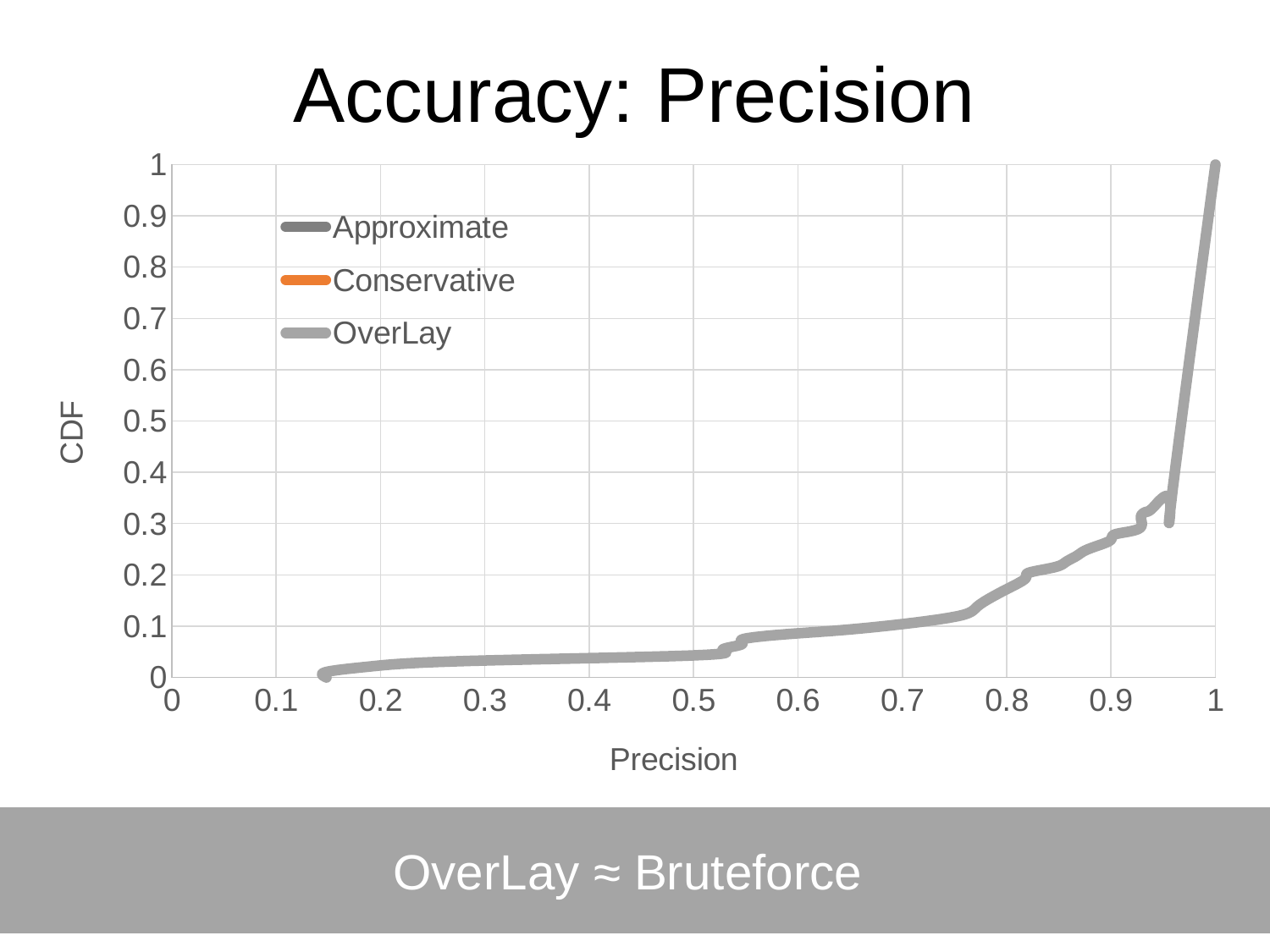
What kind of chart is shown on the slide? line chart Is the CDF value at a Precision of 0.98 greater or less than 0.5? greater What CDF value does the curve reach at a Precision of 1? 1 What is the label of the y axis? CDF Is the CDF value at a Precision of 0.7 greater or less than 0.2? less Is the CDF value at a Precision of 0.5 greater or less than 0.1? less Does the CDF curve rise or fall as Precision increases along the x axis? rise How many series does the legend list? 3 What is the title of the chart? Accuracy: Precision